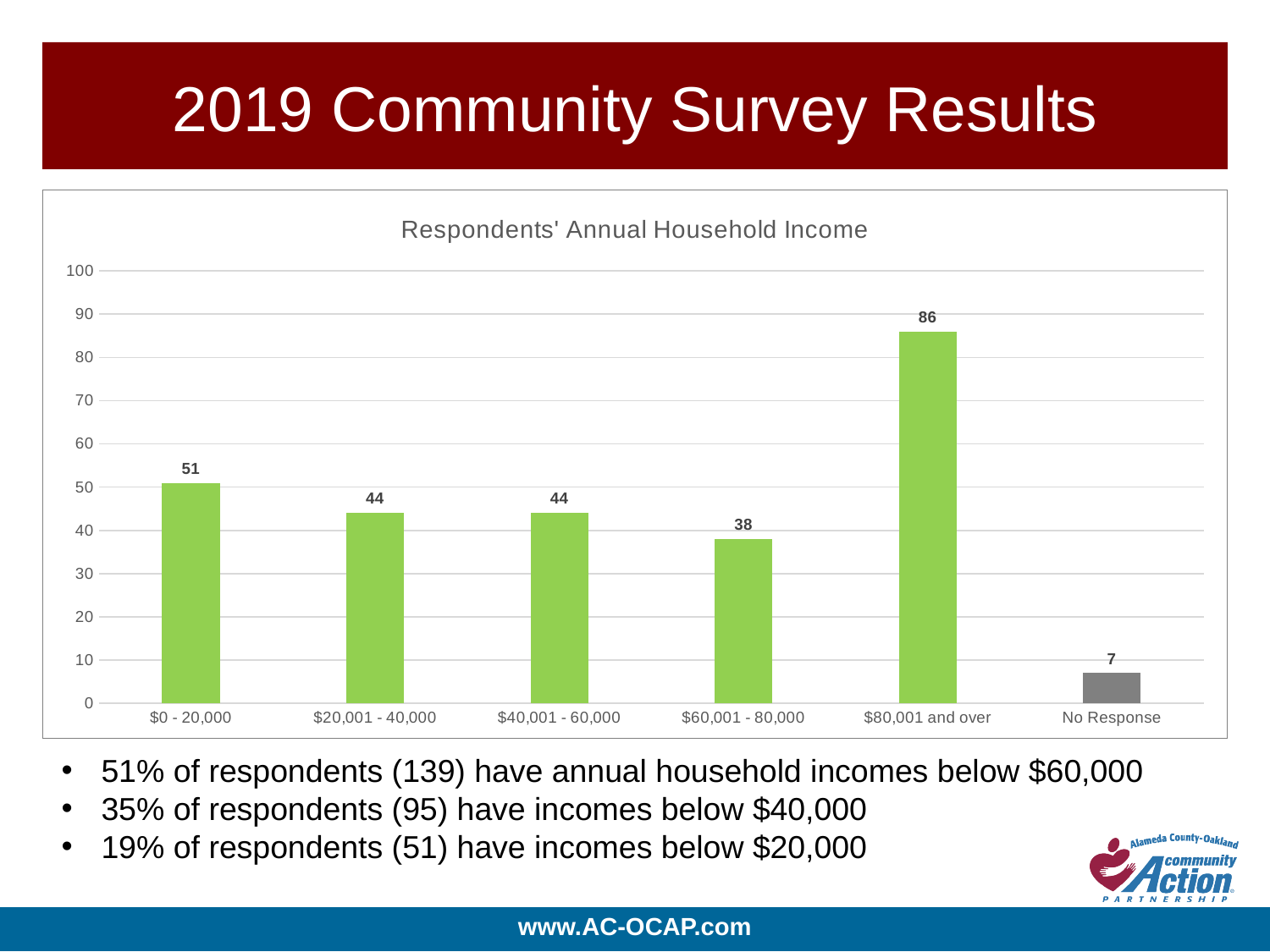
What is the difference between the values for $80,001 and over and $60,001 - 80,000? 48 How many categories are shown on the x axis? 6 Which category has the lowest value? No Response What kind of chart is this? bar chart Which bar is coloured differently from the others? No Response What is the title of the chart? Respondents' Annual Household Income What is the value for the $80,001 and over category? 86 Which is larger, the value for $0 - 20,000 or the value for $60,001 - 80,000? $0 - 20,000 Is the value for $80,001 and over greater or less than 80? greater What is the value for the $0 - 20,000 category? 51 Which category has the highest value? $80,001 and over What is the value for No Response? 7